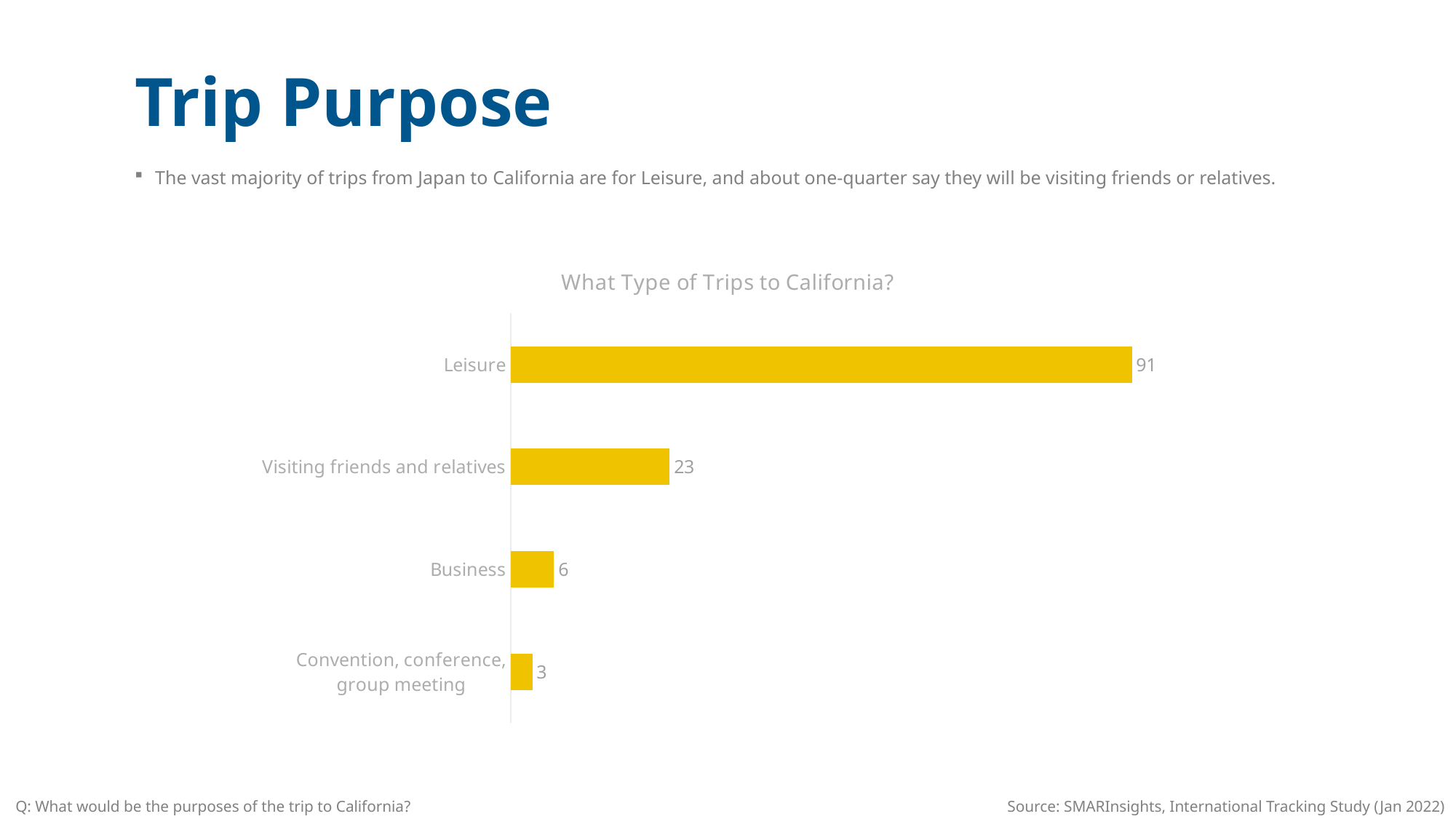
What is the value for Business? 6 How many trip purpose categories are shown in the chart? 4 What is the difference between the values for Leisure and Visiting friends and relatives? 68 Which trip purpose has the lowest value? Convention, conference, group meeting What is the value for Convention, conference, group meeting? 3 What is the title of the chart? What Type of Trips to California? What is the difference between the values for Business and Convention, conference, group meeting? 3 Which is larger, the value for Visiting friends and relatives or the value for Business? Visiting friends and relatives Which trip purpose has the highest value? Leisure What kind of chart is shown on the slide? Bar chart What is the value for Leisure? 91 What is the value for Visiting friends and relatives? 23